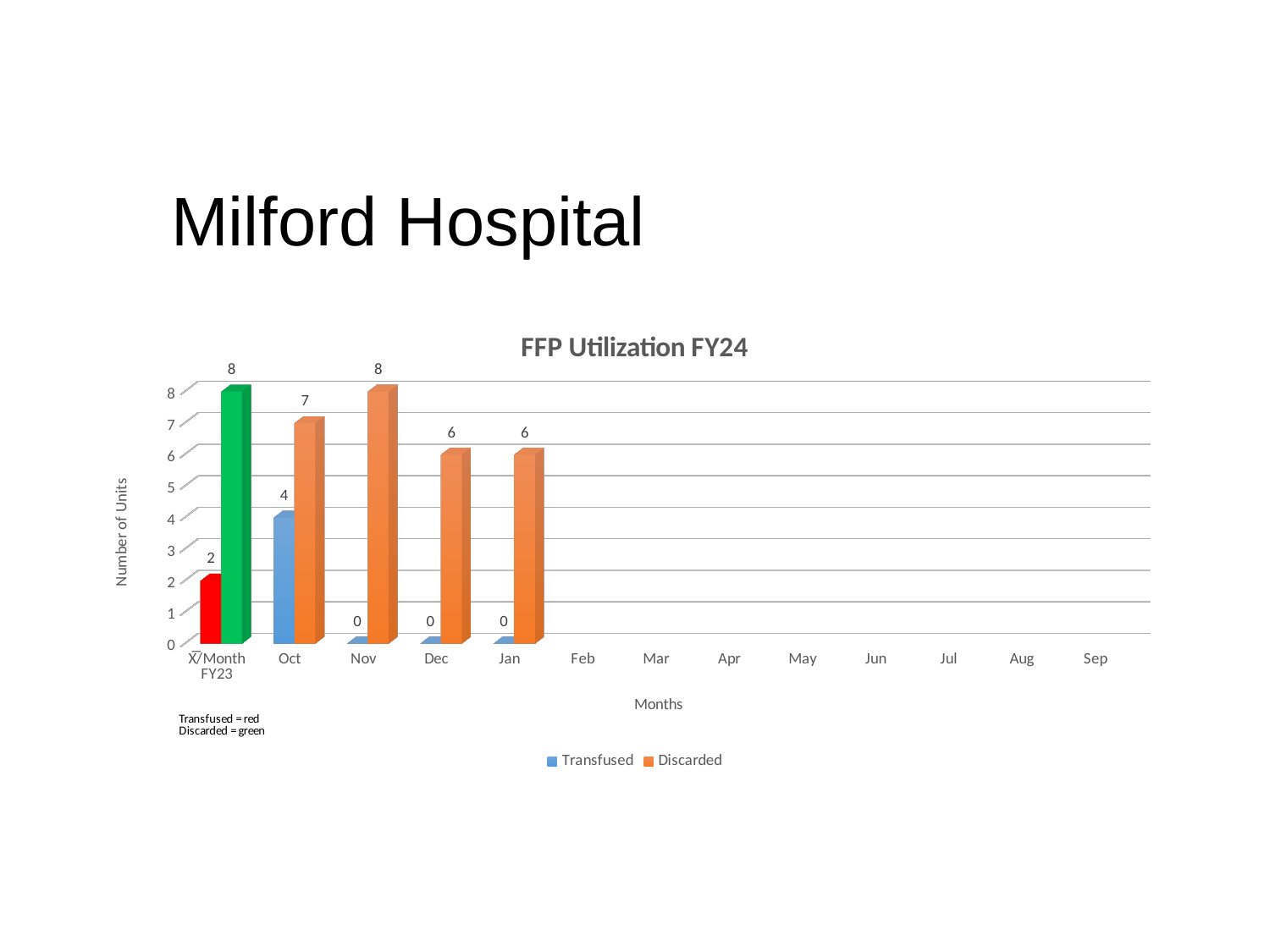
How many series does the legend list? 2 Which is larger, the Discarded value for Nov or the Discarded value for Dec? Nov What is the Transfused value for Dec? 0 Which month from Oct to Jan has the lowest Discarded value? Dec and Jan (6) What is the Discarded value for the X̄/Month FY23 category? 8 What is the difference between the Discarded and Transfused values for Oct? 3 What is the title of the chart? FFP Utilization FY24 What is the Discarded value for Oct? 7 What is the Transfused value for Oct? 4 What is the Discarded value for Nov? 8 How many month categories are labelled on the x axis? 13 What kind of chart is shown on the slide? bar chart